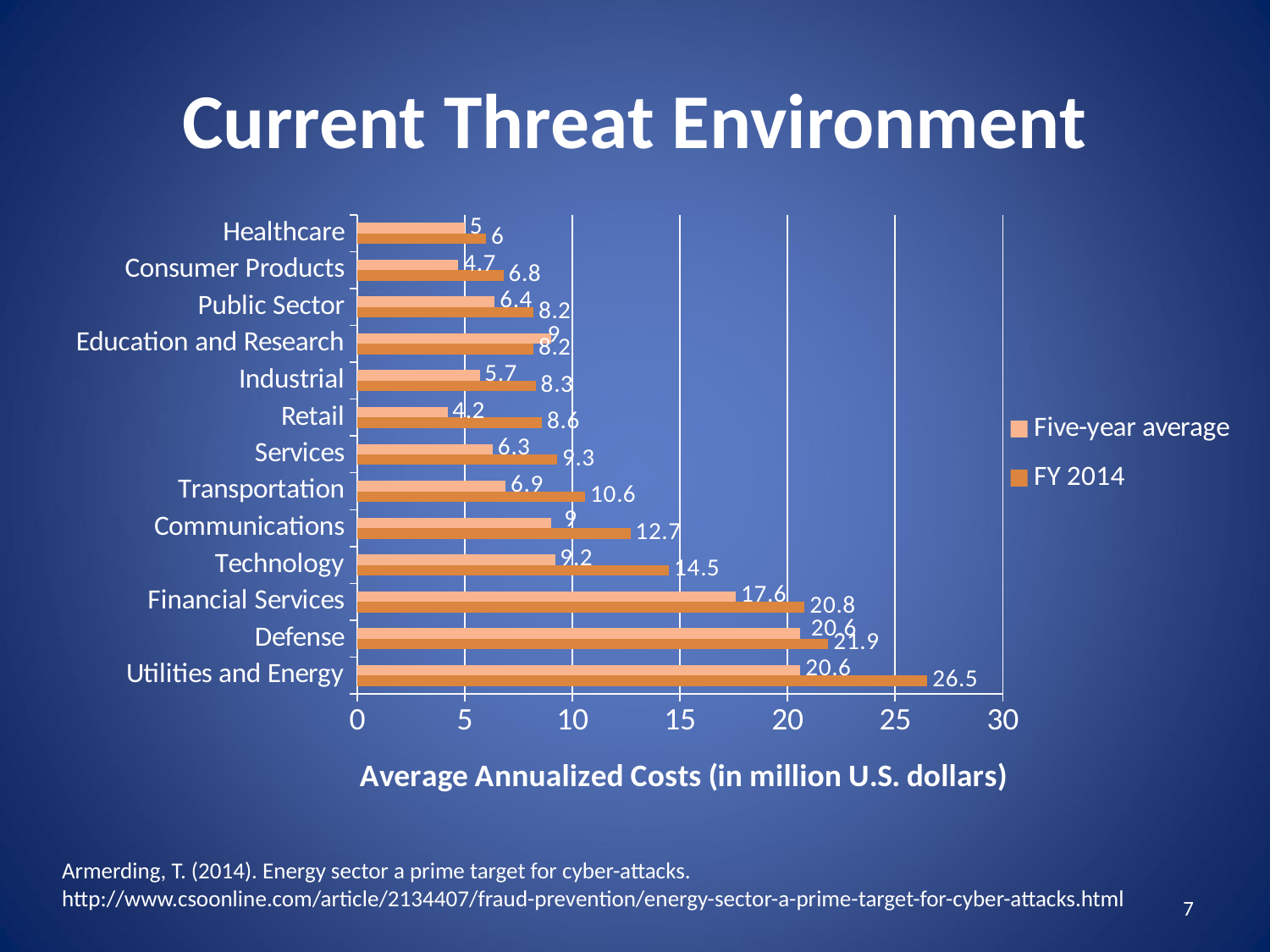
What kind of chart is shown on the slide? Bar chart Is the FY 2014 value for Communications greater or less than 10? greater What is the x-axis title of the chart? Average Annualized Costs (in million U.S. dollars) What is the FY 2014 value for Technology? 14.5 What is the Five-year average value for Financial Services? 17.6 Which category has the highest FY 2014 value? Utilities and Energy What is the FY 2014 value for Utilities and Energy? 26.5 Which category has the lowest Five-year average value? Retail How many series does the legend list? 2 Which is larger for Education and Research: the Five-year average or the FY 2014 value? Five-year average How many categories are shown on the chart? 13 What is the difference between the FY 2014 and Five-year average values for Utilities and Energy? 5.9